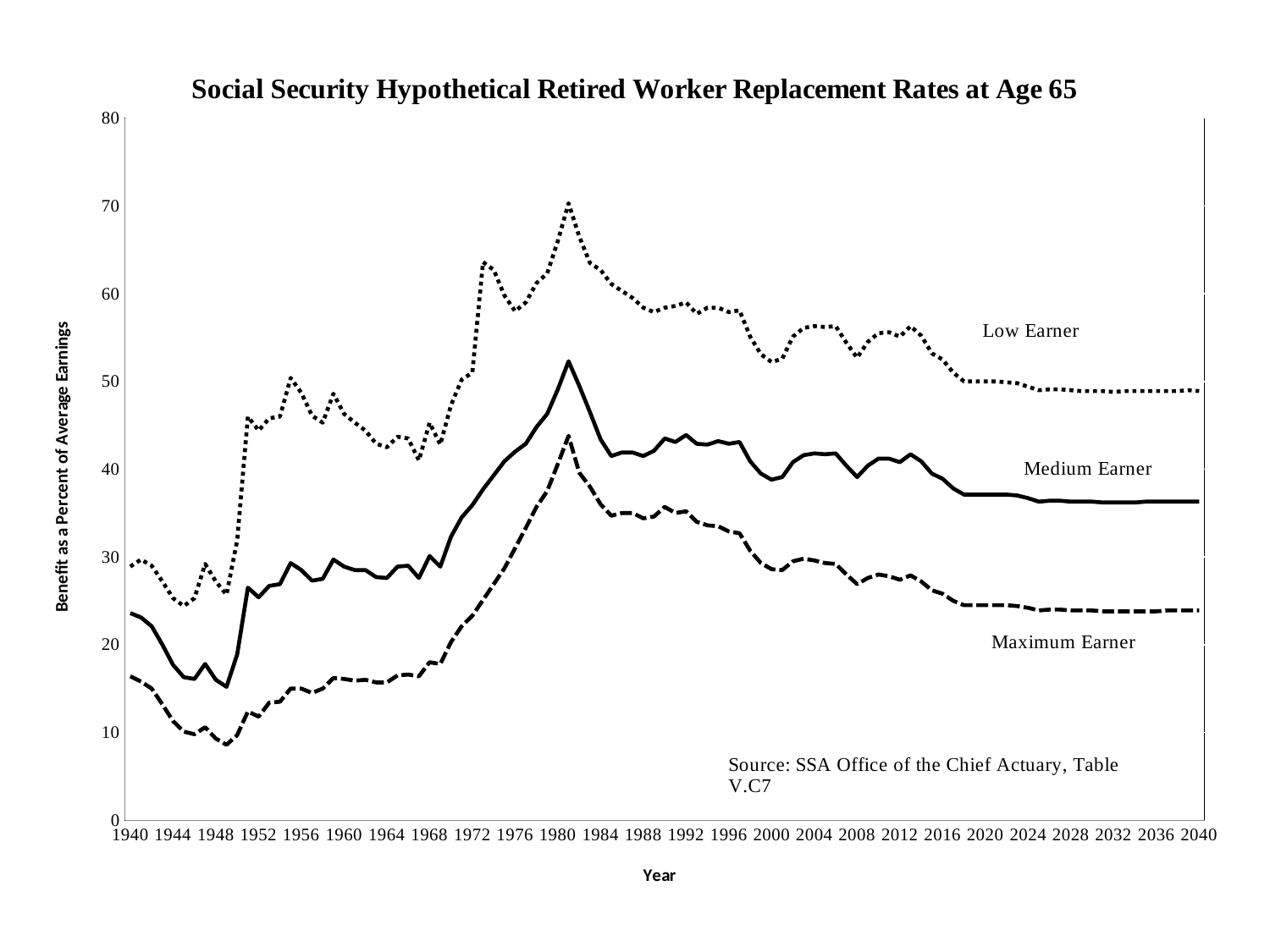
Is the value for Maximum Earner in 2040 greater or less than 20? greater Does the Maximum Earner series rise or fall between 1950 and 1980? rise Is the value for Low Earner at its 1980 peak greater or less than 60? greater What is the title of the chart? Social Security Hypothetical Retired Worker Replacement Rates at Age 65 What kind of chart is shown on the slide? Line chart Which series has the highest replacement rate across the whole chart? Low Earner How many series are plotted on the chart? 3 What is the label on the vertical axis of the chart? Benefit as a Percent of Average Earnings Is the value for Medium Earner in 2040 greater or less than 40? less Does the Medium Earner series rise or fall between 1984 and 2040? fall Which series has the lowest replacement rate across the whole chart? Maximum Earner